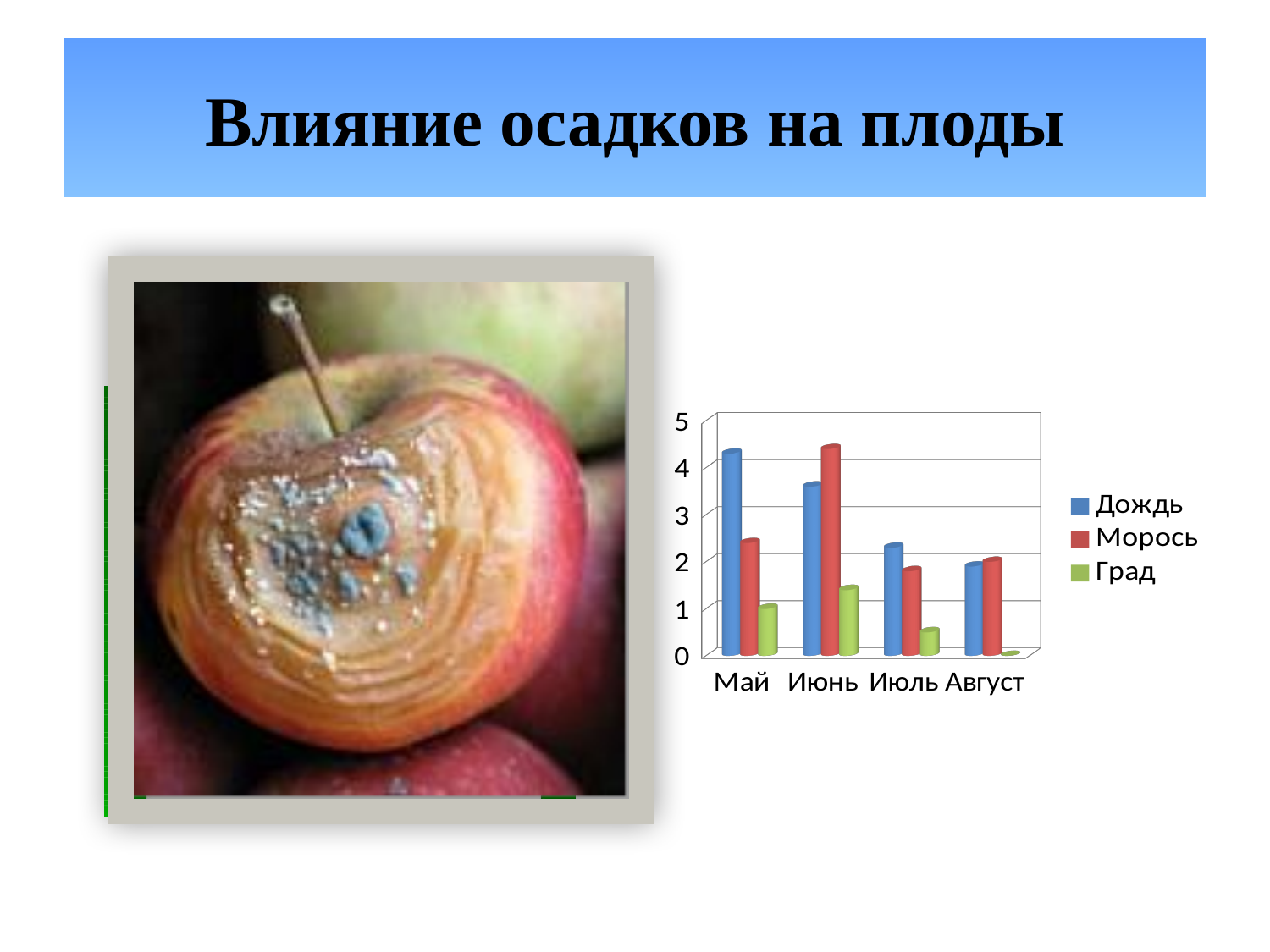
How many categories (months) are shown on the x axis of the chart? 4 In Июнь, which is larger: the value for Дождь or the value for Морось? Морось Is the value for Град in Июль greater or less than 1? less How many series does the chart's legend list? 3 In Май, which is larger: the value for Дождь or the value for Морось? Дождь In which month is the value for Дождь the highest? Май In which month is the value for Морось the highest? Июнь In which month is the value for Град the lowest? Август Do the values for Дождь rise or fall from Май to Август? fall Which series is shown in green in the chart's legend? Град What kind of chart is shown on the slide? Bar chart Is the value for Дождь in Май greater or less than 4? greater